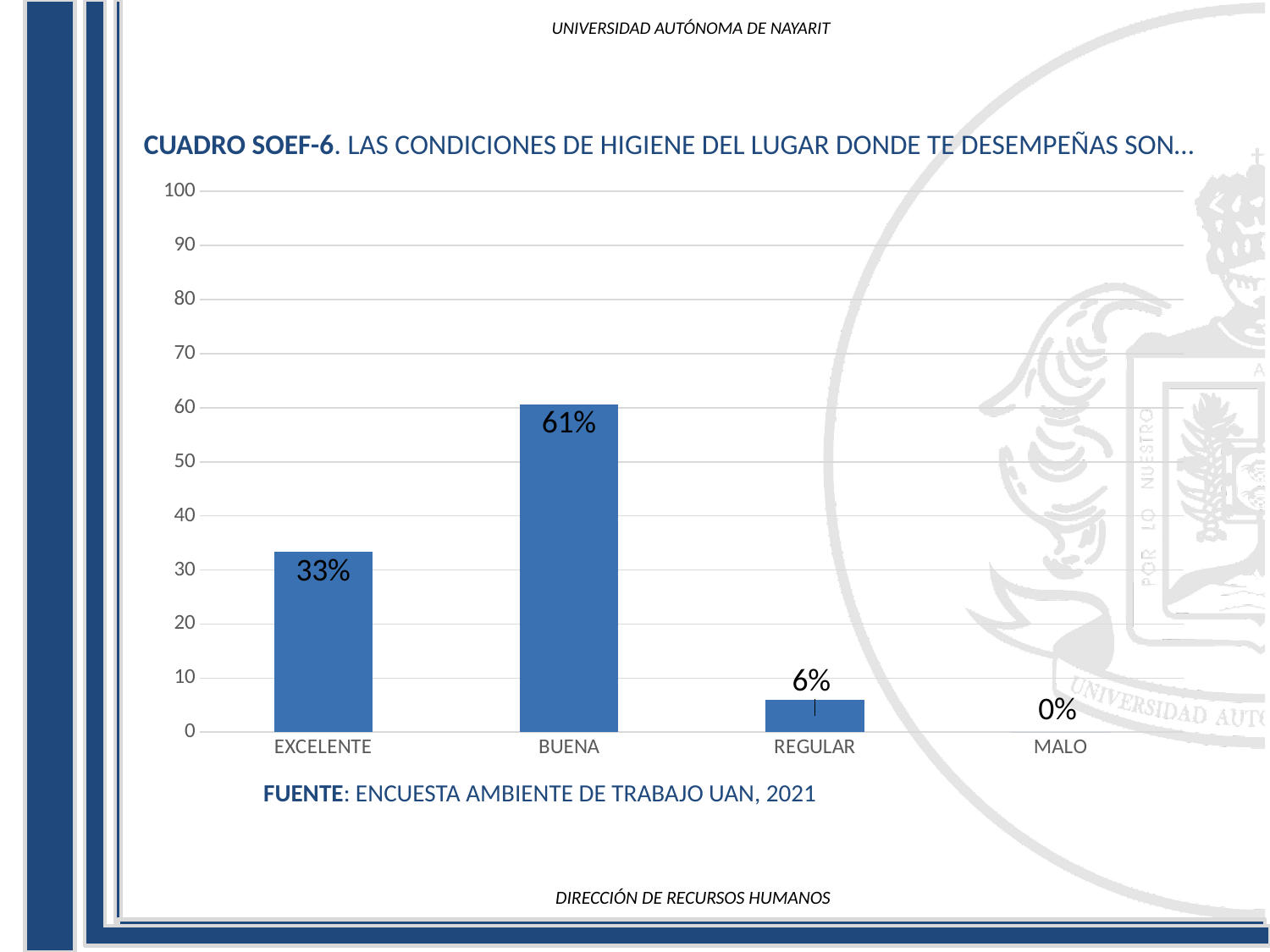
Which category has the lowest value? MALO What kind of chart is shown on the slide? Bar chart What is the difference between the values for BUENA and EXCELENTE? 28% Which category has the highest value? BUENA Which is larger, the value for EXCELENTE or the value for REGULAR? EXCELENTE What is the value for BUENA? 61% What is the value for EXCELENTE? 33% How many categories are shown on the x axis? 4 Is the value for BUENA greater or less than 50? greater What is the value for REGULAR? 6% What source is cited below the chart? ENCUESTA AMBIENTE DE TRABAJO UAN, 2021 What is the value for MALO? 0%